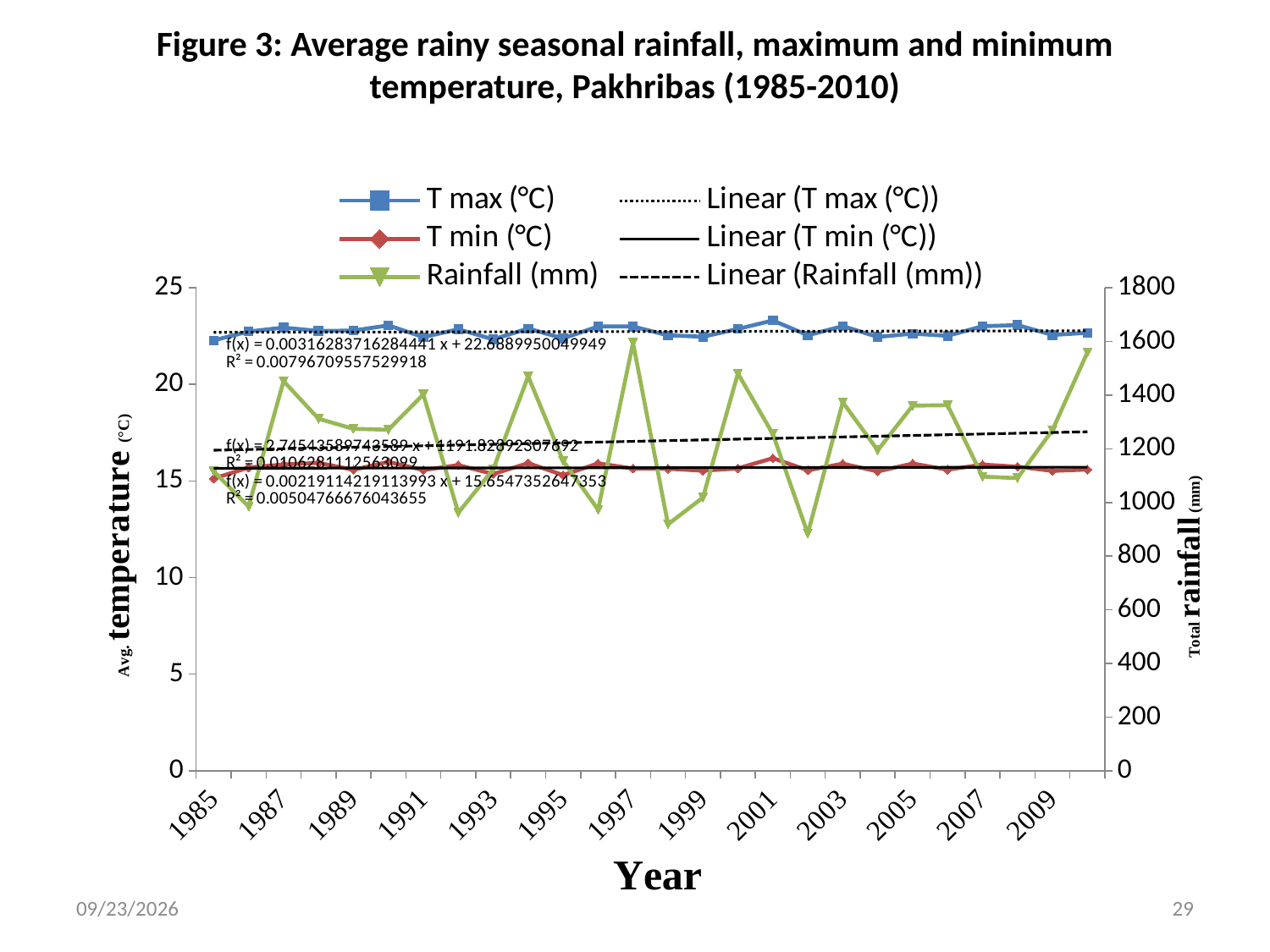
What is the label of the right-hand y axis? Total rainfall (mm) Is the T max (°C) value for 1985 greater or less than 20? greater Is the Rainfall (mm) value for 1997 greater or less than 1400? greater What is the label of the x axis? Year Is the Rainfall (mm) value for 2002 greater or less than 1000? less Which is larger, the Rainfall (mm) value for 1997 or for 2002? 1997 How many entries does the chart legend list? 6 Does the Linear (Rainfall (mm)) trendline rise or fall from left to right? rises What kind of chart is shown on the slide? Line chart Which series has higher values throughout the chart, T max (°C) or T min (°C)? T max (°C)